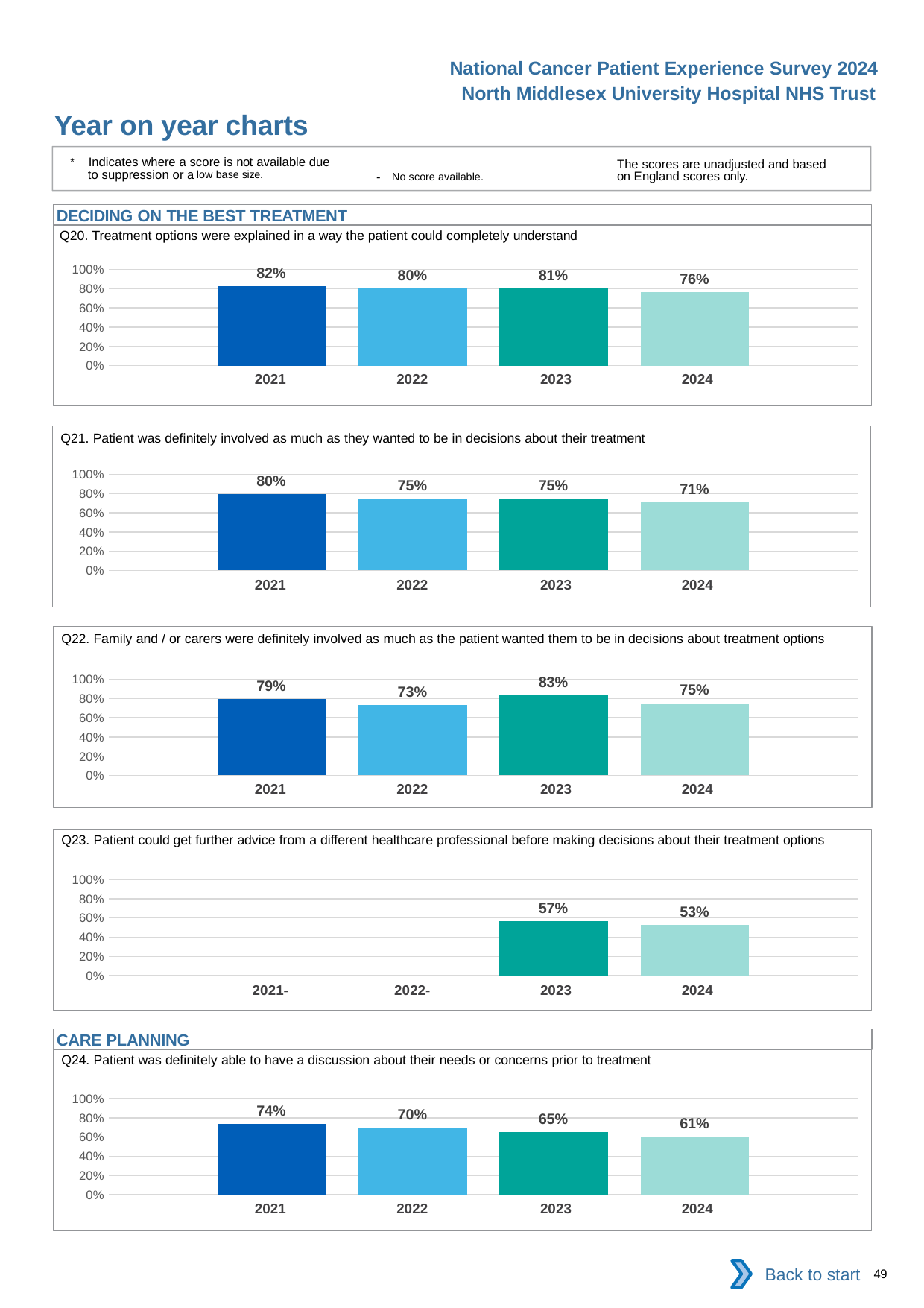
In the Q24 chart, do the values rise or fall from 2021 to 2024? fall In the Q20 chart, what is the value for 2024? 76% In the Q22 chart, which year has the highest value? 2023 In the Q21 chart, which year has the lowest value? 2024 In the Q24 chart, what is the difference between the 2021 and 2024 values? 13 percentage points What type of chart is used for Q20? bar chart In the Q23 chart, what is the value for 2023? 57% In the Q23 chart, how many years have a bar plotted? 2 In the Q20 chart, which year has the highest value? 2021 In the Q21 chart, what is the difference between the 2021 and 2024 values? 9 percentage points In the Q24 chart, which is larger, the value for 2022 or the value for 2023? 2022 In the Q22 chart, what is the value for 2022? 73%